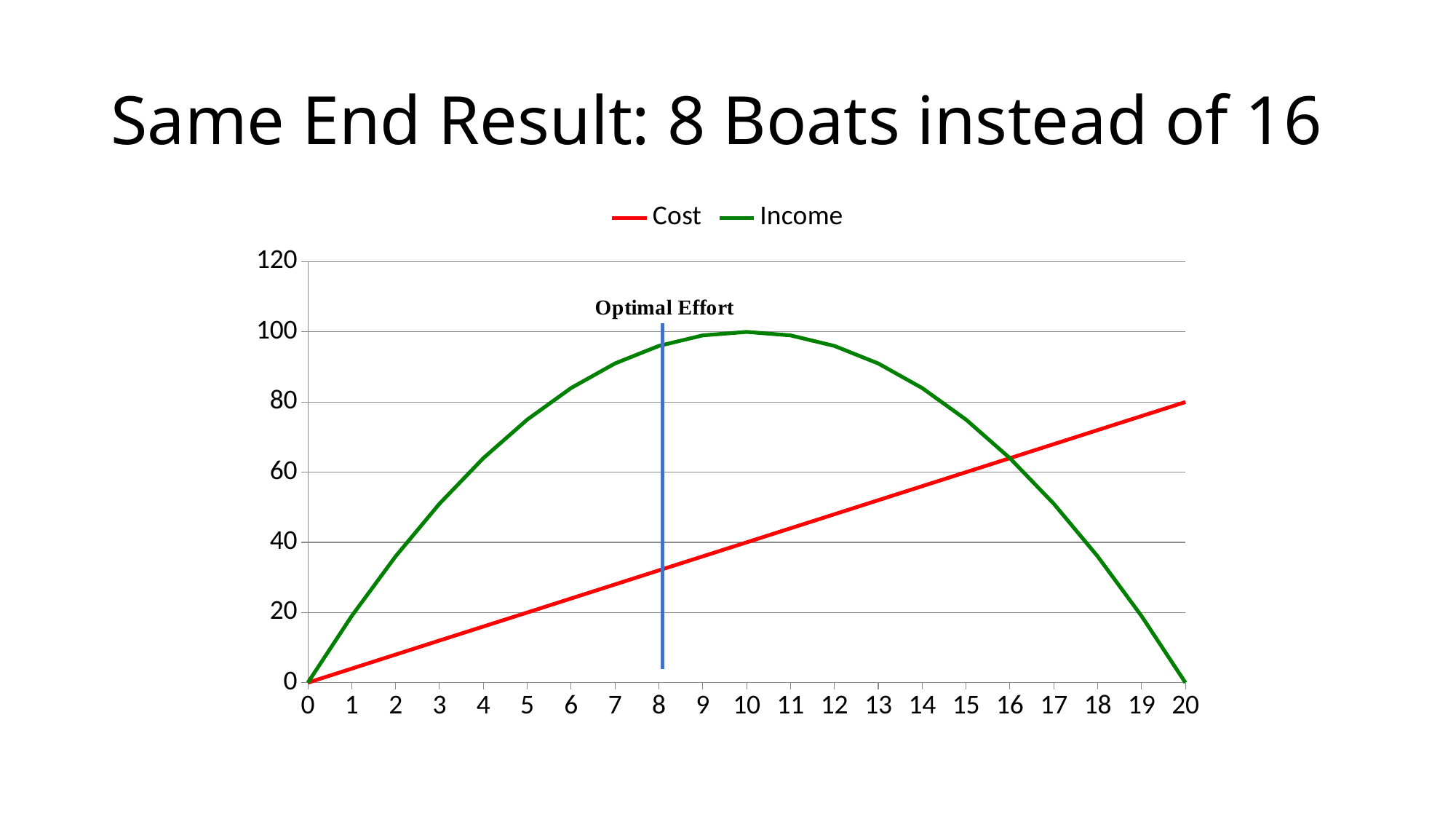
Is the value of Income at x = 8 greater or less than 80? greater What is the value of Income at x = 20? 0 At which x value does Income reach its highest point? 10 How many series does the legend list? 2 At x = 18, which is larger, Cost or Income? Cost Which two series are listed in the legend? Cost and Income What kind of chart is shown on the slide? line chart Does the Cost line rise or fall as x increases? rise At which x value does the vertical line labelled "Optimal Effort" sit? 8 What is the value of Cost at x = 20? 80 Is the value of Cost at x = 8 greater or less than 40? less What is the value of Income at x = 10? 100